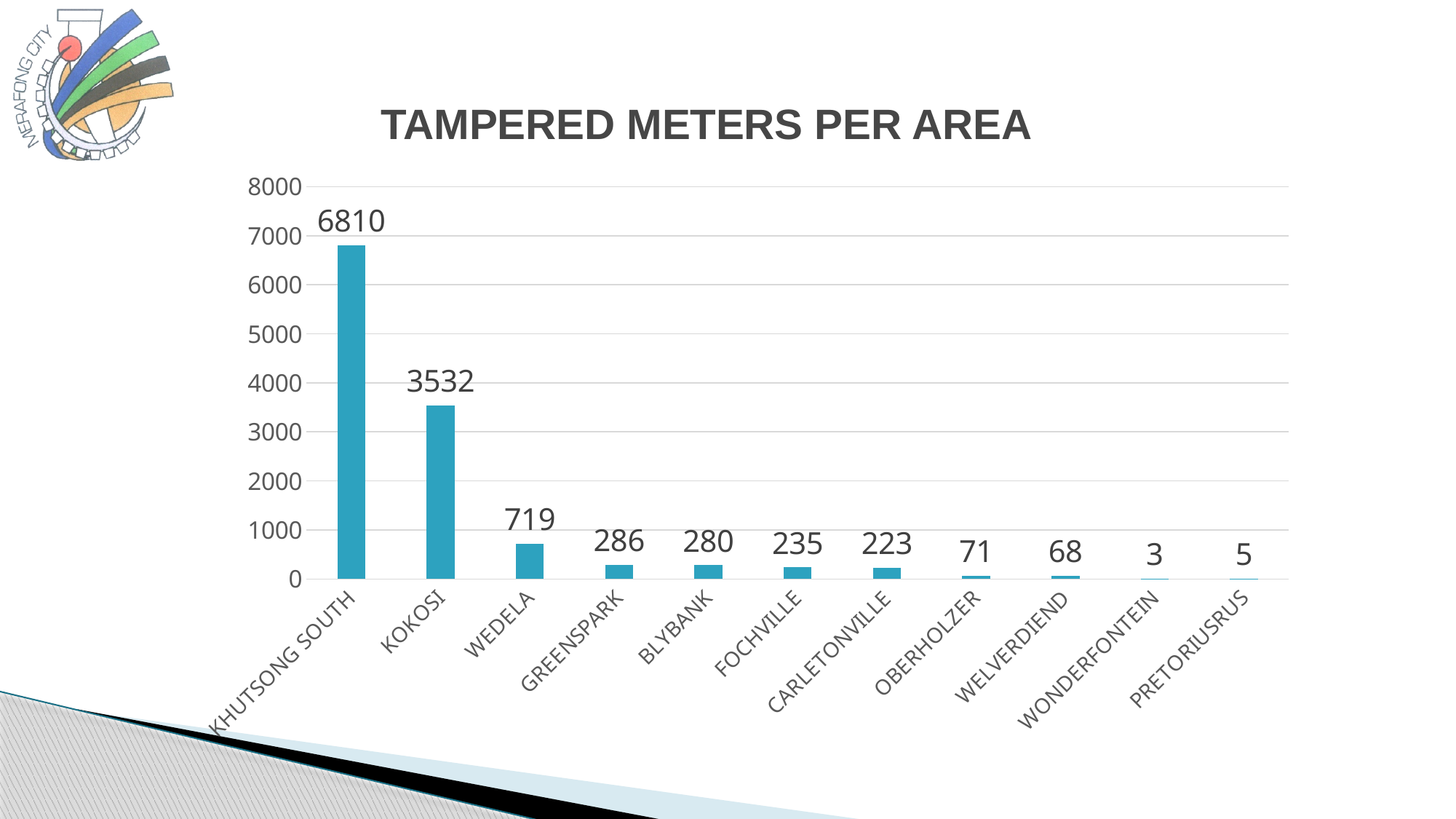
What is the value for KHUTSONG SOUTH? 6810 What is the difference between the values for GREENSPARK and BLYBANK? 6 How many areas are shown on the chart? 11 Which is larger, the value for FOCHVILLE or the value for CARLETONVILLE? FOCHVILLE Is the value for KOKOSI greater or less than 3000? greater Which area has the lowest number of tampered meters? WONDERFONTEIN What is the value for KOKOSI? 3532 Which area has the highest number of tampered meters? KHUTSONG SOUTH What kind of chart is shown on the slide? bar chart What is the value for OBERHOLZER? 71 What is the value for WEDELA? 719 What is the difference between the values for KHUTSONG SOUTH and KOKOSI? 3278